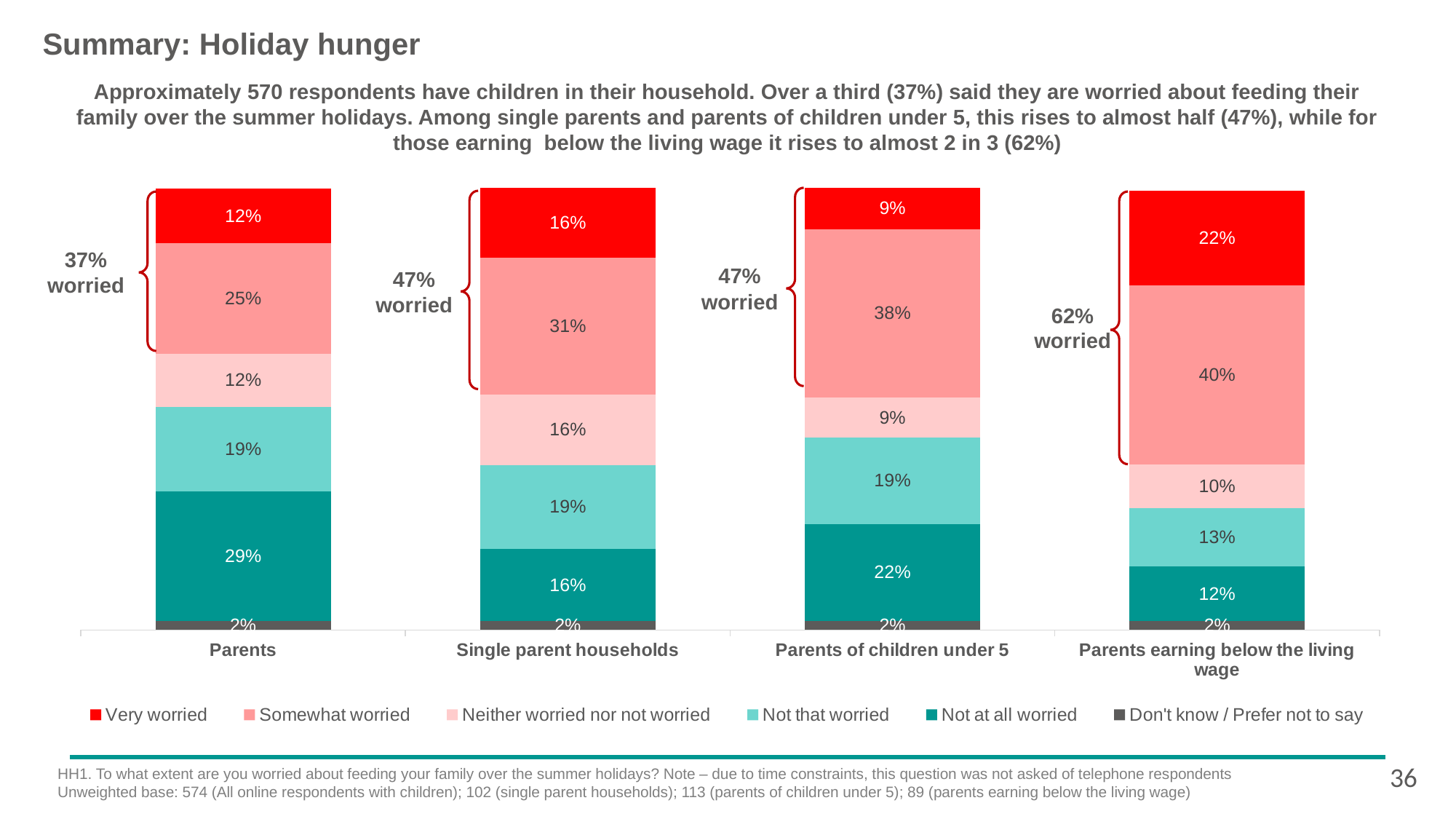
How many series does the legend list? 6 What percentage of Single parent households are 'Somewhat worried'? 31% What is the combined 'worried' total (Very worried plus Somewhat worried) shown for Parents earning below the living wage? 62% What percentage of Parents of children under 5 are 'Not at all worried'? 22% Which is larger: the 'Not at all worried' share for Parents or for Single parent households? Parents What is the difference in the 'Somewhat worried' percentage between Parents earning below the living wage and Parents? 15 percentage points What percentage of Parents are 'Very worried'? 12% Which category has the highest 'Very worried' percentage? Parents earning below the living wage How many categories are shown on the x axis? 4 What kind of chart is shown on the slide? Stacked bar chart Which category has the lowest 'Very worried' percentage? Parents of children under 5 What percentage of Parents earning below the living wage are 'Not that worried'? 13%